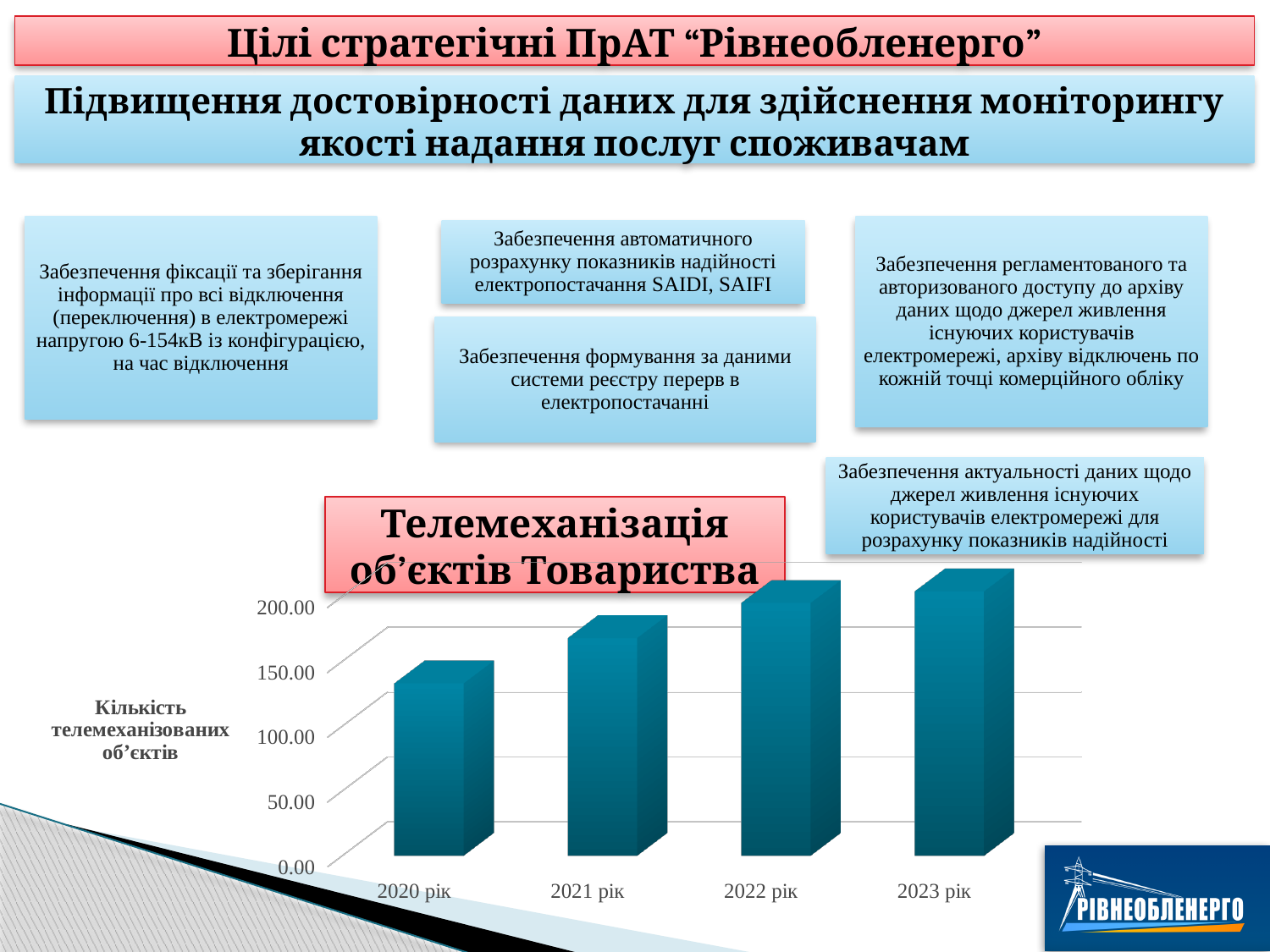
What kind of chart is shown on the slide? bar chart Which is larger, the value for 2021 рік or the value for 2022 рік? 2022 рік Which year has the highest value in the chart? 2023 рік Which is larger, the value for 2020 рік or the value for 2023 рік? 2023 рік Is the value for 2023 рік greater or less than 150.00? greater Do the values rise or fall from 2020 рік to 2023 рік? rise Is the value for 2020 рік greater or less than 100.00? greater How many categories (years) are shown on the x axis of the chart? 4 Which year has the lowest value in the chart? 2020 рік Is the value for 2021 рік greater or less than 100.00? greater What is the title of the chart? Телемеханізація об’єктів Товариства What is the label of the vertical axis of the chart? Кількість телемеханізованих об’єктів